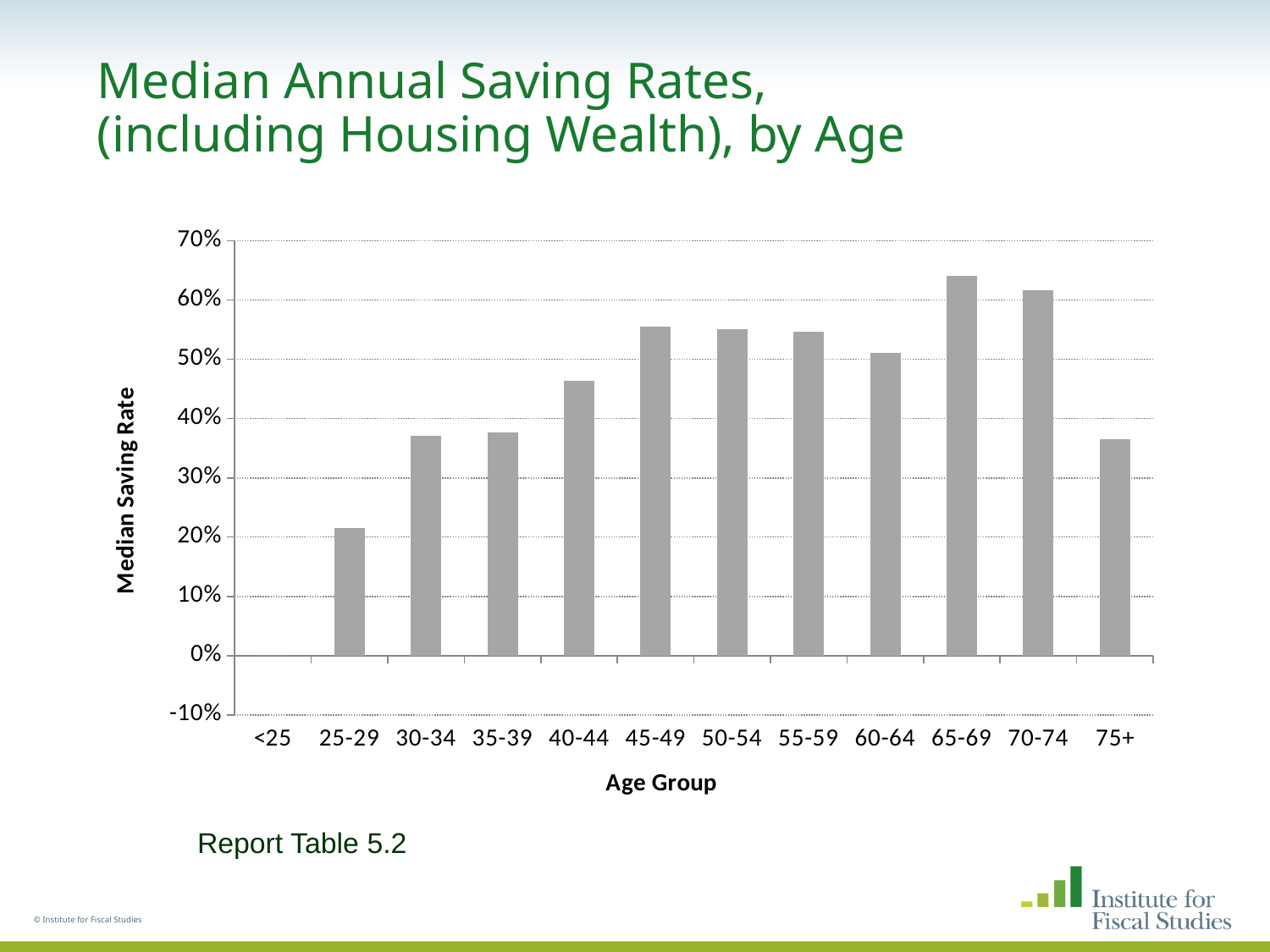
Is the median saving rate for the 40-44 age group greater or less than 50%? less Is the median saving rate for the 65-69 age group greater or less than 60%? greater Which has the higher median saving rate, the 25-29 age group or the 75+ age group? 75+ Is the median saving rate for the 75+ age group greater or less than 30%? greater Which has the higher median saving rate, the 40-44 age group or the 45-49 age group? 45-49 How many age groups are listed along the x axis? 12 What is the label on the vertical axis of the chart? Median Saving Rate What kind of chart is shown on the slide? Bar chart Do the median saving rates rise or fall from the 25-29 age group to the 45-49 age group? rise Which age group has the highest median saving rate? 65-69